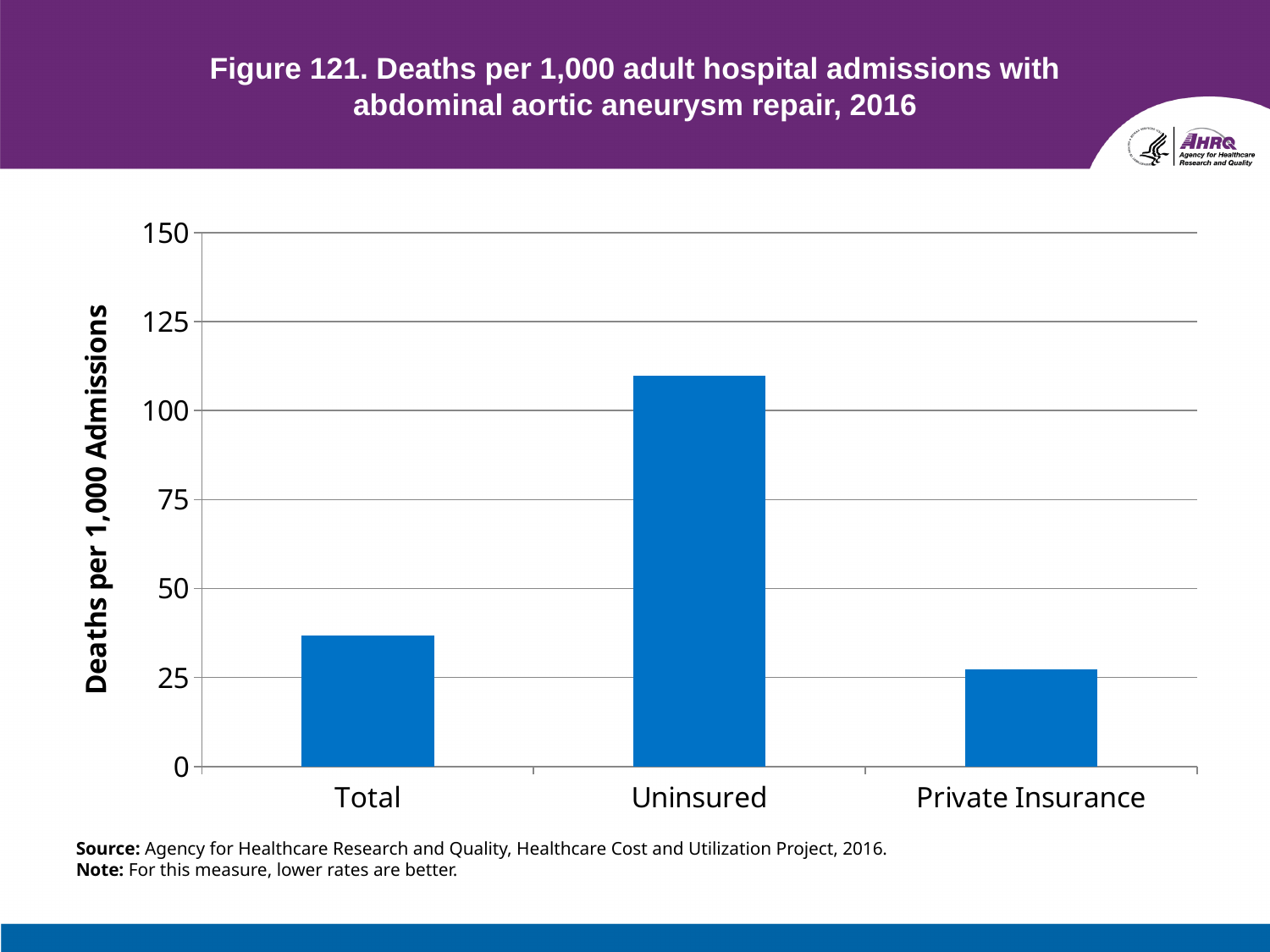
How many categories are shown on the x axis? 3 Which category has the lowest deaths per 1,000 admissions? Private Insurance Is the value for Private Insurance greater or less than 50? less Is the value for Uninsured greater or less than 100? greater What year does the chart title say the data is from? 2016 Which is larger, the value for Total or the value for Private Insurance? Total Is the value for Total greater or less than 25? greater Which category has the highest deaths per 1,000 admissions? Uninsured What is the label of the y axis? Deaths per 1,000 Admissions What kind of chart is shown on the slide? bar chart